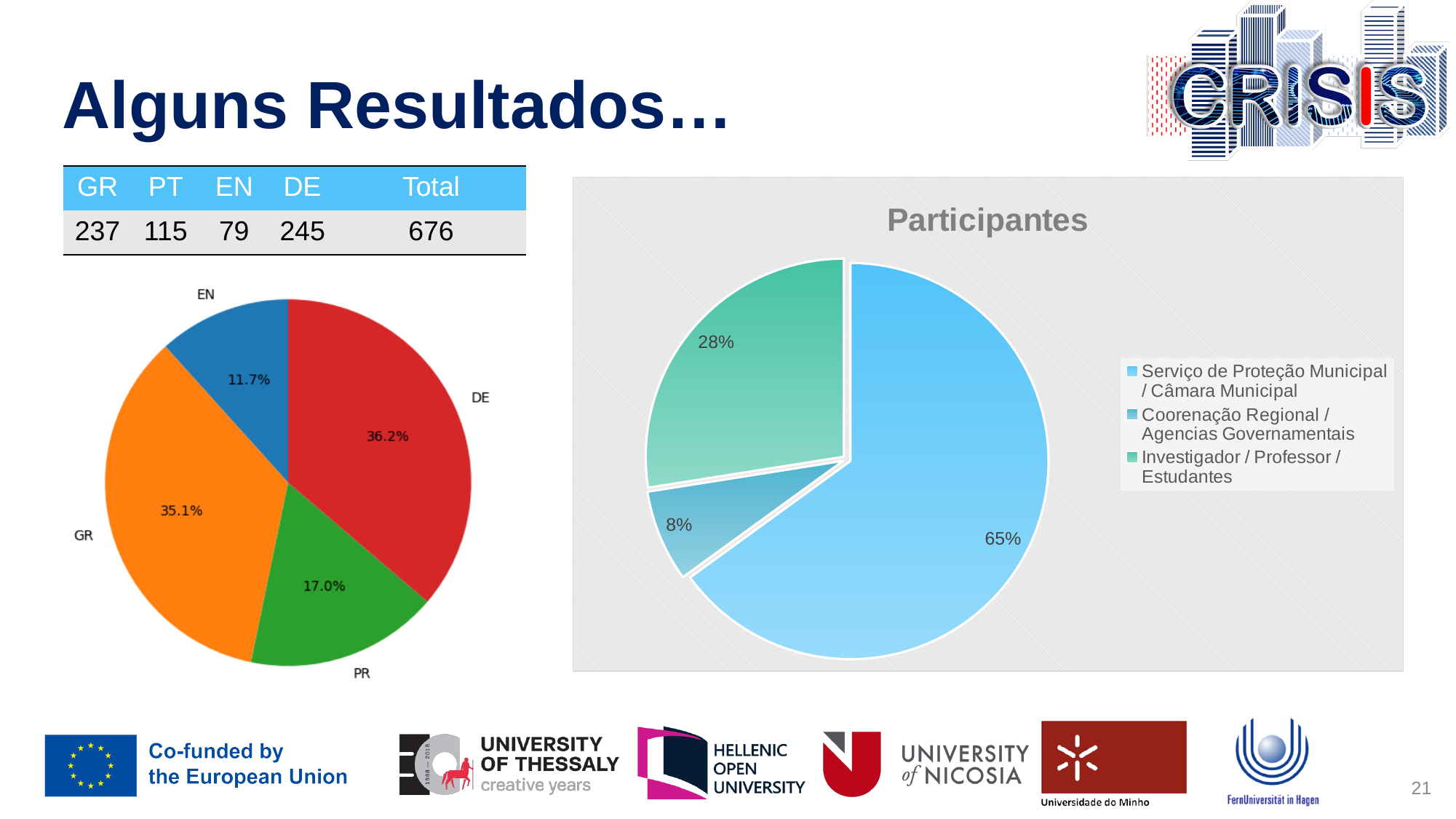
What type of chart is the chart on the left of the slide? pie chart In the pie chart on the left, what share does the DE slice have? 36.2% How many entries does the legend of the 'Participantes' chart list? 3 What type of chart is the 'Participantes' chart? pie chart In the pie chart on the left, what share does the EN slice have? 11.7% In the 'Participantes' chart, what share does 'Serviço de Proteção Municipal / Câmara Municipal' have? 65% In the pie chart on the left, how many slices are there? 4 In the 'Participantes' chart, what is the difference between the largest and smallest slices? 57% In the pie chart on the left, what is the difference between the PR share and the EN share? 5.3% In the pie chart on the left, which slice is the smallest? EN In the 'Participantes' chart, which category has the smallest share? Coorenação Regional / Agencias Governamentais